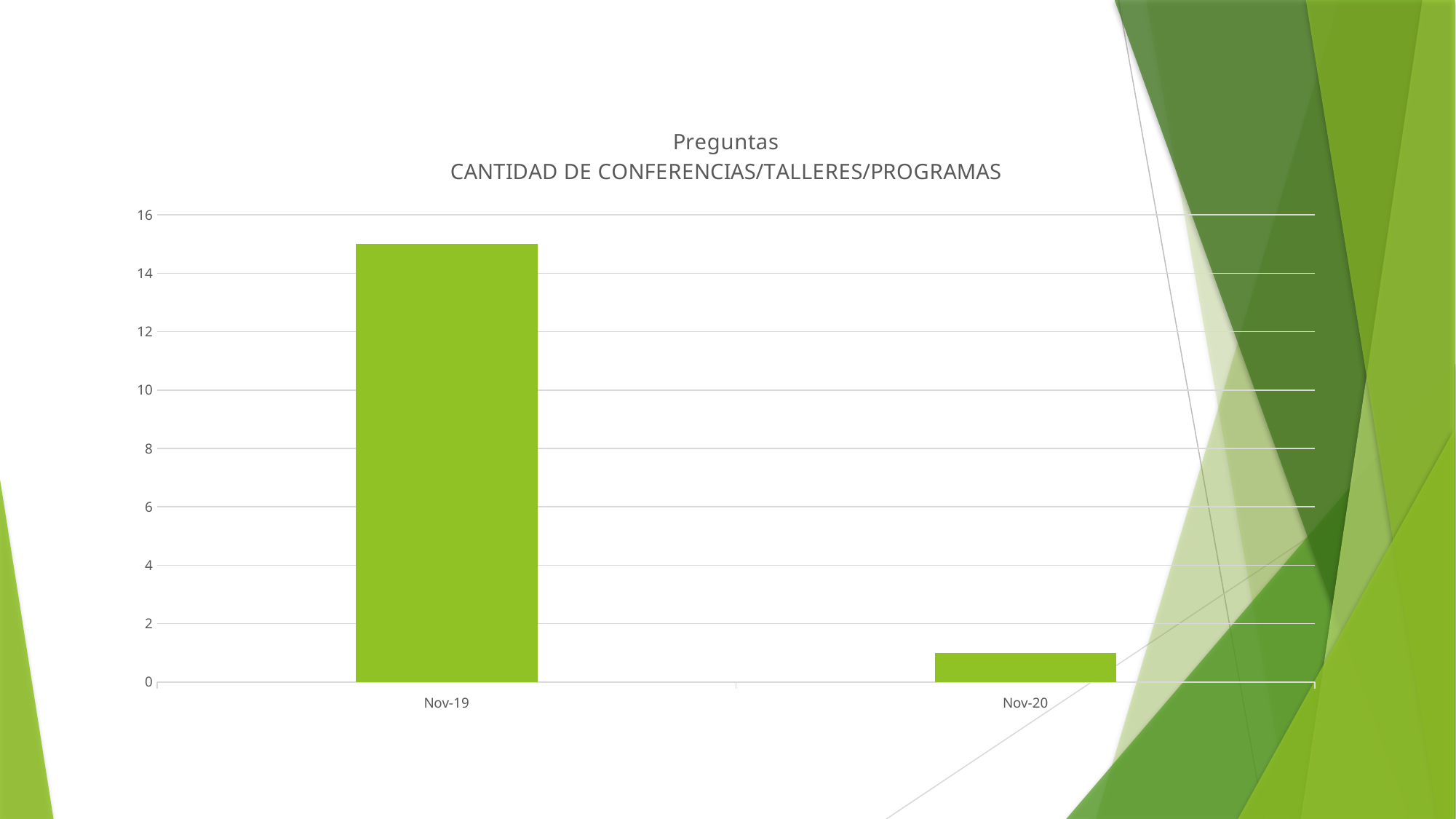
Is the value for Nov-19 greater or less than 14? greater Which category has the lowest value in the chart? Nov-20 Is the value for Nov-19 greater or less than 16? less Is the value for Nov-20 greater or less than 10? less Which is larger, the value for Nov-19 or the value for Nov-20? Nov-19 What is the title of the chart? Preguntas CANTIDAD DE CONFERENCIAS/TALLERES/PROGRAMAS Which category has the highest value in the chart? Nov-19 What is the highest value shown on the vertical axis of the chart? 16 Do the values rise or fall from Nov-19 to Nov-20? Fall What kind of chart is shown on the slide? Bar chart How many categories are shown on the x axis of the chart? 2